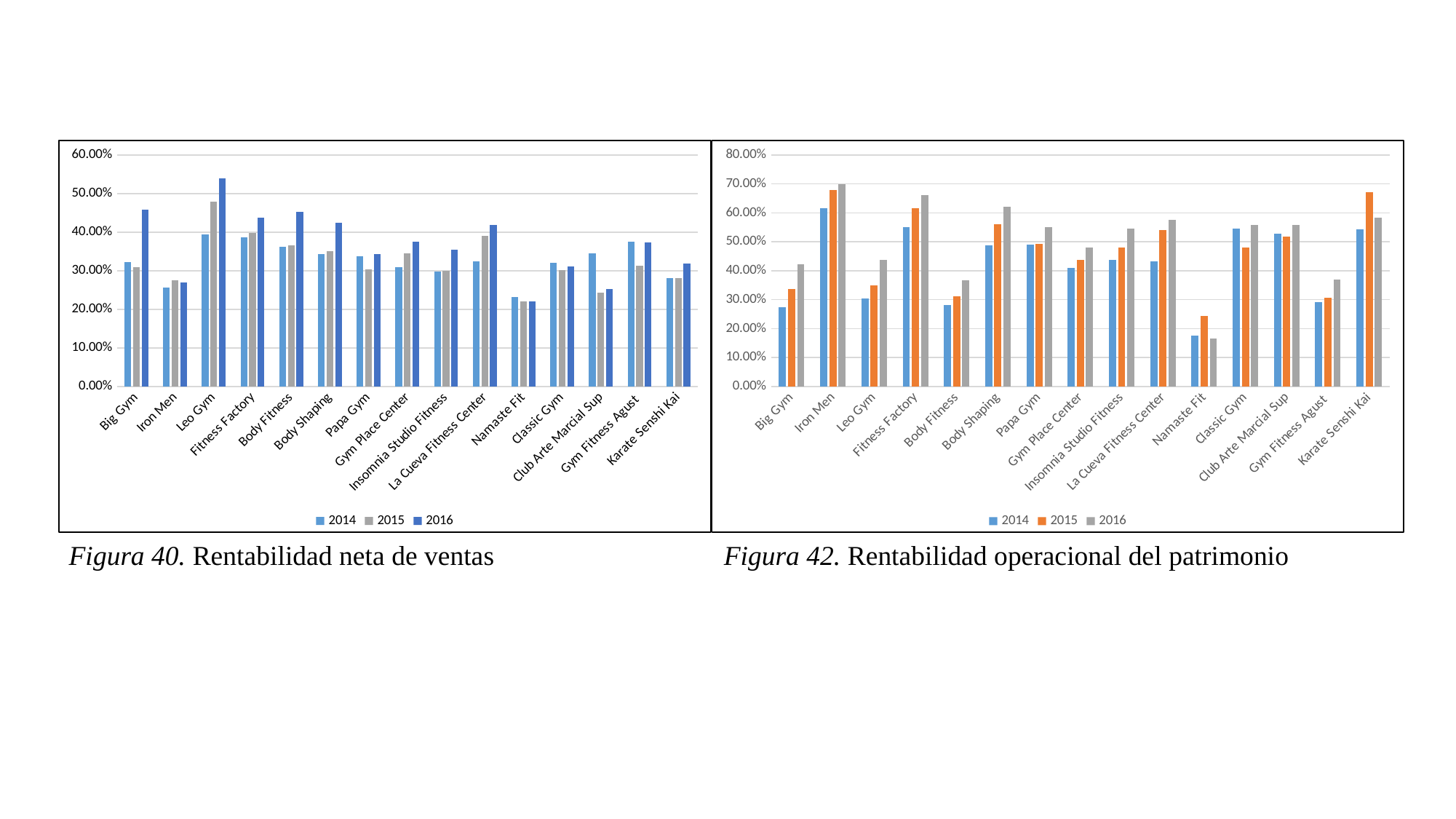
How many gyms (categories) are shown on the x axis of Figura 40? 15 In Figura 40 (Rentabilidad neta de ventas), which gym has the highest bar overall? Leo Gym What kind of chart is Figura 40 (Rentabilidad neta de ventas)? bar chart In Figura 40, is the 2014 value for Iron Men greater or less than 30.00%? less In Figura 42, is the 2016 value for Fitness Factory greater or less than 60.00%? greater How many series does the legend of Figura 42 (Rentabilidad operacional del patrimonio) list? 3 In Figura 42, which is larger: the 2014 value for Iron Men or the 2014 value for Big Gym? Iron Men In Figura 40, which is larger: the 2016 value for Leo Gym or the 2016 value for Big Gym? Leo Gym What colour represents the 2015 series in Figura 42 (Rentabilidad operacional del patrimonio)? orange In Figura 40, is the 2016 value for Big Gym greater or less than 40.00%? greater In Figura 42 (Rentabilidad operacional del patrimonio), which gym has the lowest values? Namaste Fit In Figura 40 (Rentabilidad neta de ventas), which gym has the lowest values across all three years? Namaste Fit